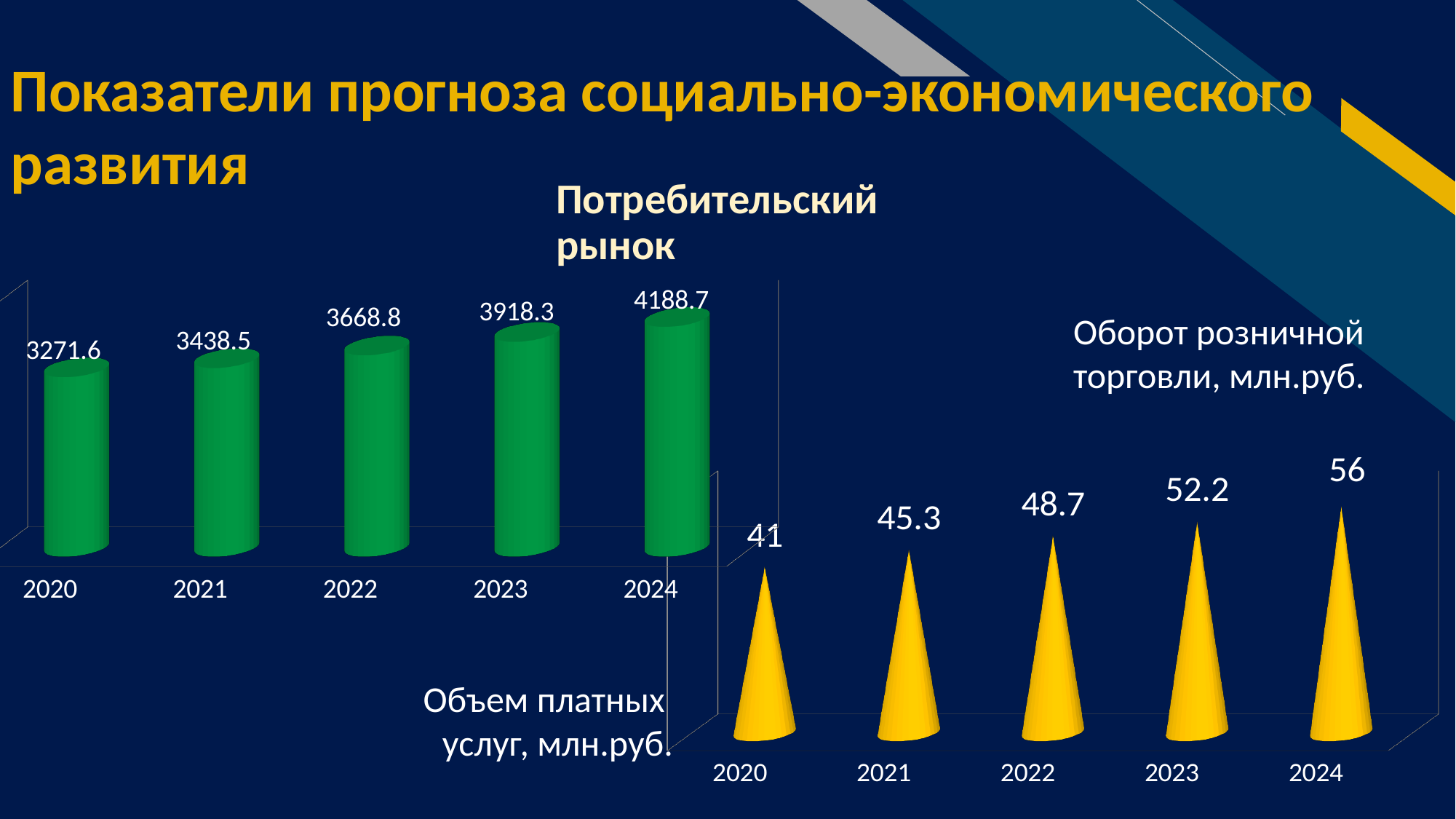
On the right chart with yellow cones, what is the value for 2021? 45.3 On the right chart with yellow cones, what is the difference between the values for 2023 and 2022? 3.5 On the right chart with yellow cones, do the values rise or fall from 2020 to 2024? rise On the right chart with yellow cones, what is the value for 2024? 56 On the left chart with green bars, what is the value for 2023? 3918.3 On the left chart with green bars, which year has the highest value? 2024 What type of chart is the left chart with green bars? bar chart On the left chart with green bars, what is the difference between the values for 2024 and 2020? 917.1 On the left chart with green bars, which is larger: the value for 2021 or the value for 2022? 2022 On the right chart with yellow cones, which year has the lowest value? 2020 On the left chart with green bars, what is the value for 2020? 3271.6 How many years are shown on the right chart with yellow cones? 5